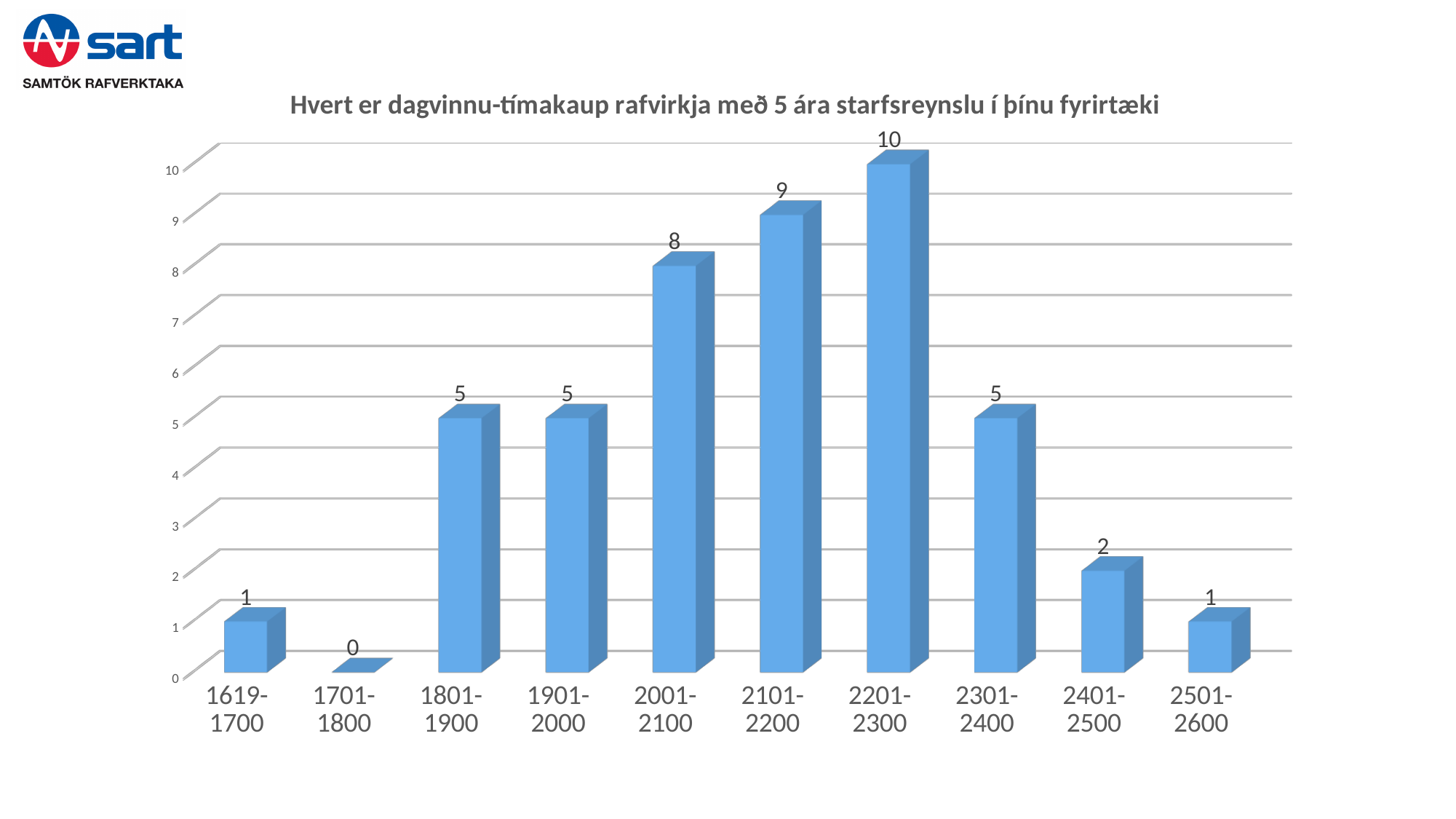
Do the values rise or fall from 1801-1900 to 2201-2300? rise What is the value for the 1701-1800 category? 0 Which category has the highest value? 2201-2300 Which category has the lowest value? 1701-1800 What is the value for the 2201-2300 category? 10 Which is larger, the value for 2101-2200 or the value for 2301-2400? 2101-2200 How many categories are shown on the x axis? 10 What is the value for the 2401-2500 category? 2 Is the value for 2001-2100 greater or less than 5? greater What is the difference between the values for 2201-2300 and 2001-2100? 2 What kind of chart is shown on the slide? bar chart What is the title of the chart? Hvert er dagvinnu-tímakaup rafvirkja með 5 ára starfsreynslu í þínu fyrirtæki